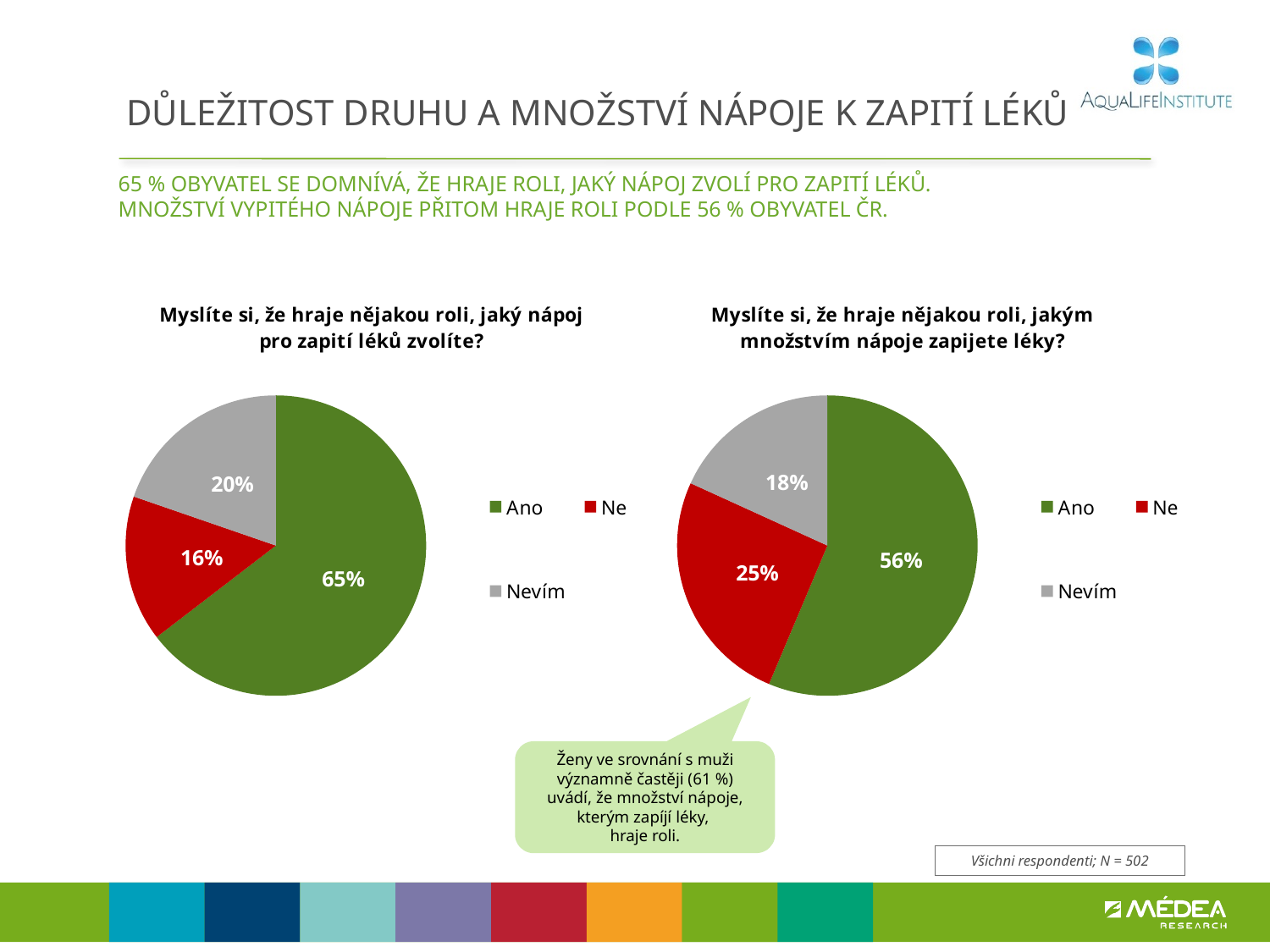
In the left pie chart, which category has the largest share? Ano Which is larger: the Ne share in the left pie chart or the Ne share in the right pie chart? The right pie chart (25%) In the right pie chart ("Myslíte si, že hraje nějakou roli, jakým množstvím nápoje zapijete léky?"), what is the value for Ne? 25% What type of chart is used on the right side of the slide? Pie chart In the left pie chart ("Myslíte si, že hraje nějakou roli, jaký nápoj pro zapití léků zvolíte?"), what is the value for Ano? 65% In the right pie chart, which category has the smallest share? Nevím In the right pie chart, what colour is the Nevím slice? Grey In the right pie chart ("Myslíte si, že hraje nějakou roli, jakým množstvím nápoje zapijete léky?"), what is the value for Ano? 56% How many categories does the left pie chart show? 3 In the right pie chart, what is the difference between the Ne and Nevím shares? 7 percentage points In the left pie chart ("Myslíte si, že hraje nějakou roli, jaký nápoj pro zapití léků zvolíte?"), what is the value for Nevím? 20% In the left pie chart, what is the difference between the Ano and Ne shares? 49 percentage points